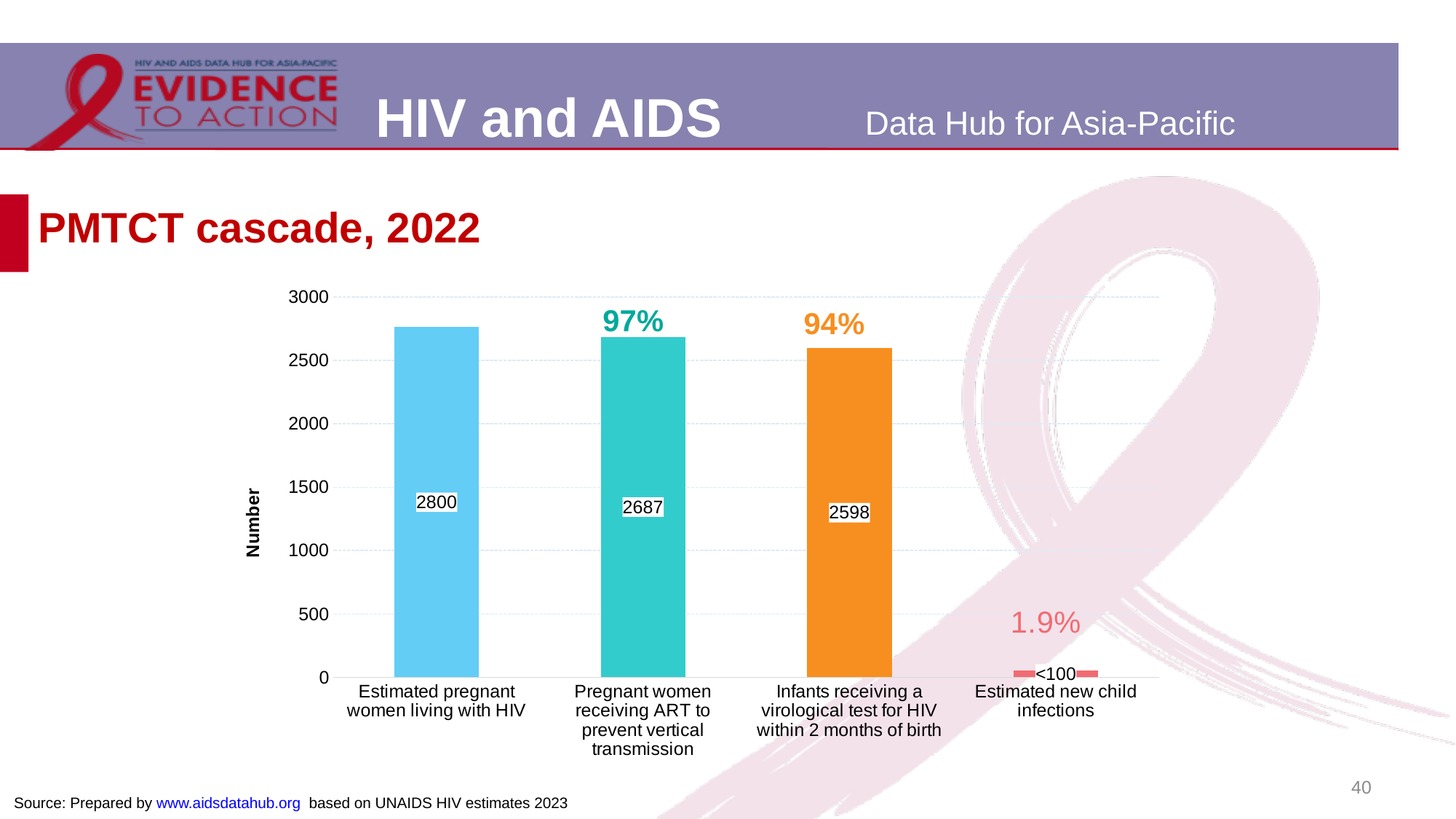
What percentage is printed above the bar for Infants receiving a virological test for HIV within 2 months of birth? 94% What is the value shown for Estimated new child infections? <100 Which category has the highest value? Estimated pregnant women living with HIV What is the value for Pregnant women receiving ART to prevent vertical transmission? 2687 What is the difference between Pregnant women receiving ART to prevent vertical transmission and Infants receiving a virological test for HIV within 2 months of birth? 89 What is the value for Estimated pregnant women living with HIV? 2800 Which is larger: Pregnant women receiving ART to prevent vertical transmission or Infants receiving a virological test for HIV within 2 months of birth? Pregnant women receiving ART to prevent vertical transmission What is the difference between Estimated pregnant women living with HIV and Pregnant women receiving ART to prevent vertical transmission? 113 What kind of chart is this? Bar chart What is the value for Infants receiving a virological test for HIV within 2 months of birth? 2598 How many categories are shown on the x axis? 4 Which category has the lowest value? Estimated new child infections